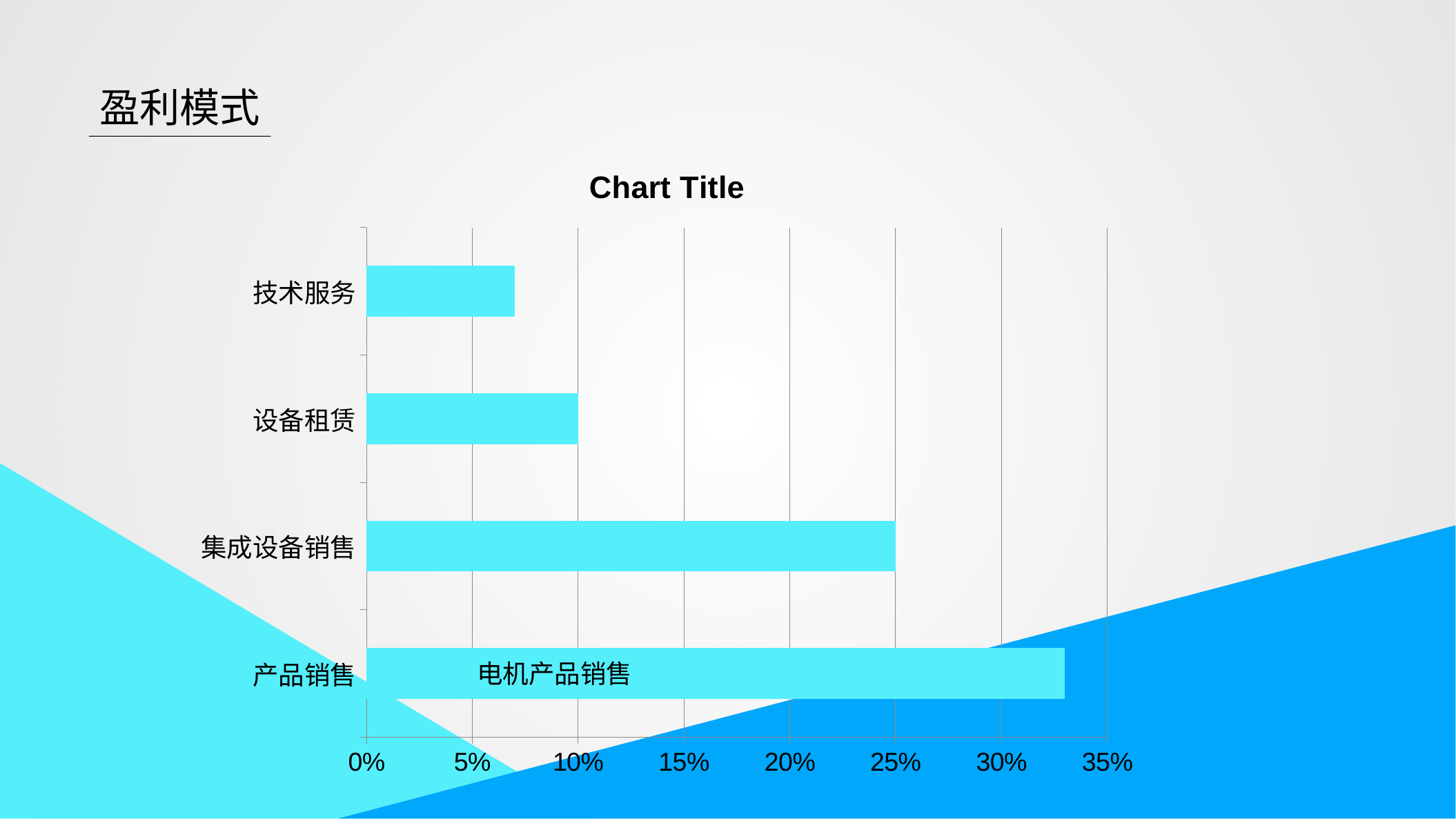
Which category has the lowest value in the chart? 技术服务 Which category has the highest value in the chart? 产品销售 What is the title of the chart? Chart Title Which is larger, the value for 设备租赁 or the value for 技术服务? 设备租赁 Is the value for 产品销售 greater or less than 30%? greater What text label is written on the 产品销售 bar? 电机产品销售 What is the difference between the values for 集成设备销售 and 设备租赁? 15% How many categories are plotted in the chart? 4 Is the value for 技术服务 greater or less than 10%? less What kind of chart is shown on the slide? bar chart What is the value for 设备租赁? 10% What is the value for 集成设备销售? 25%